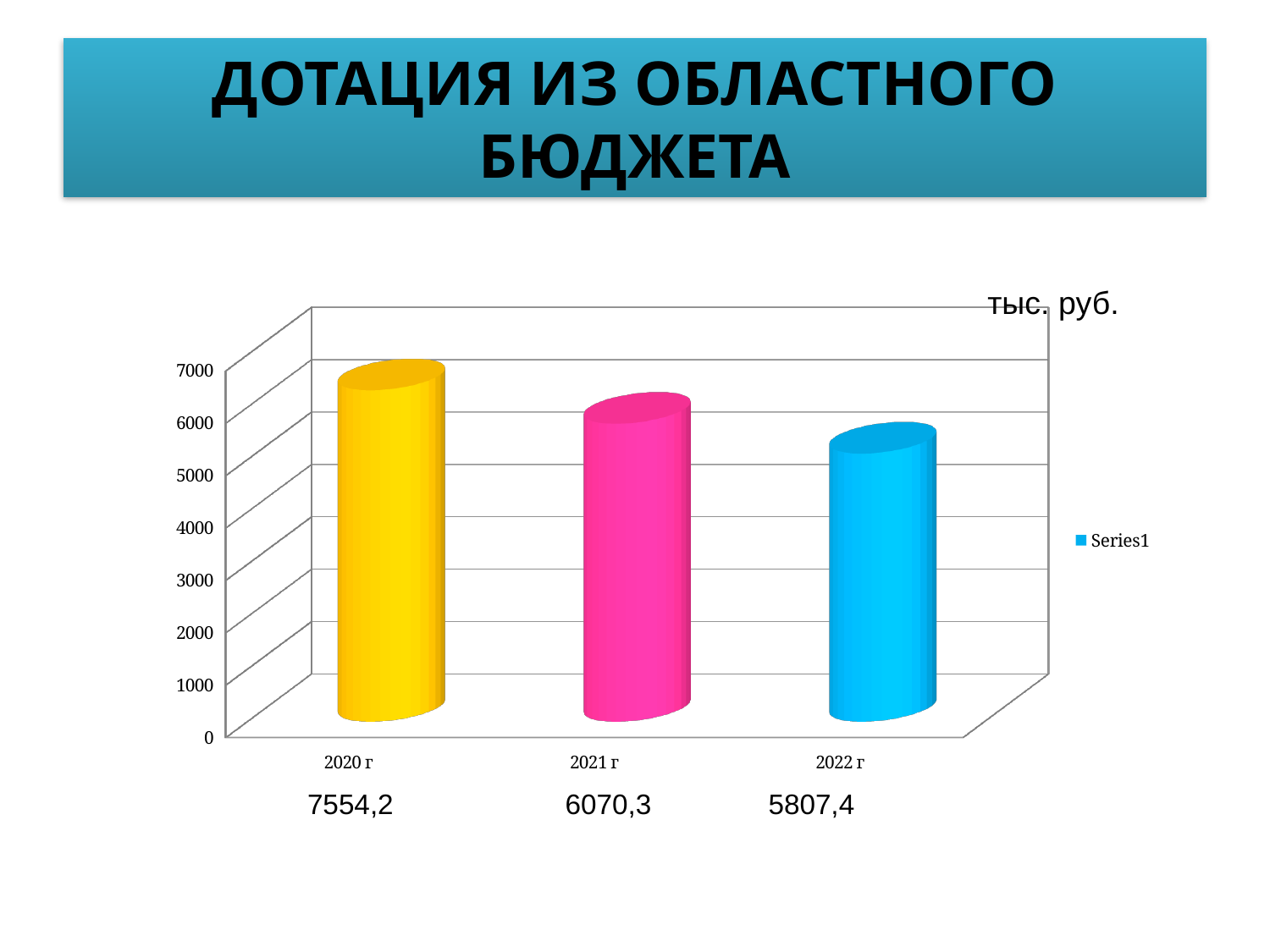
What is the difference between the values for 2021 г and 2022 г? 262,9 Which is larger, the value for 2020 г or the value for 2022 г? 2020 г What is the value for 2020 г? 7554,2 What is the value for 2021 г? 6070,3 What is the value for 2022 г? 5807,4 Is the value for 2022 г greater or less than 6000? less Which year has the highest value? 2020 г Which year has the lowest value? 2022 г What is the difference between the values for 2020 г and 2021 г? 1483,9 How many years are shown on the chart? 3 Do the values rise or fall from 2020 г to 2022 г? fall What kind of chart is shown on the slide? bar chart